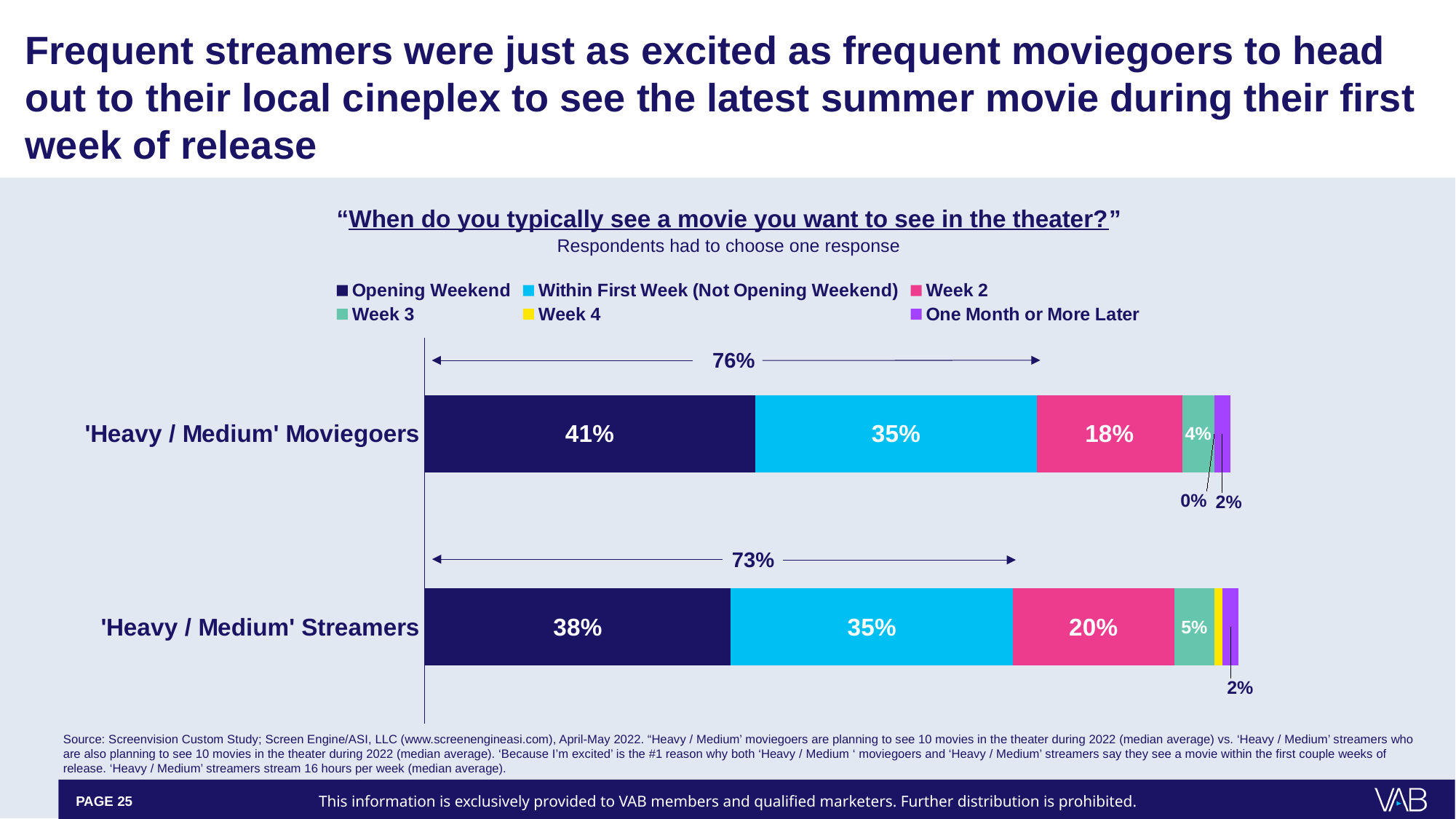
How many respondent groups (categories) are plotted in the chart? 2 What is the Week 4 value for 'Heavy / Medium' Moviegoers? 0% Which group has the larger Opening Weekend share, 'Heavy / Medium' Moviegoers or 'Heavy / Medium' Streamers? 'Heavy / Medium' Moviegoers How many series does the legend list? 6 Which legend entry is shown in yellow? Week 4 What is the Week 3 value for 'Heavy / Medium' Moviegoers? 4% What is the Opening Weekend value for 'Heavy / Medium' Streamers? 38% What combined share of 'Heavy / Medium' Moviegoers see a movie within the first week (Opening Weekend plus Within First Week), as annotated on the chart? 76% What is the Week 2 value for 'Heavy / Medium' Streamers? 20% What is the difference between the Week 2 values for 'Heavy / Medium' Streamers and 'Heavy / Medium' Moviegoers? 2% What is the Opening Weekend value for 'Heavy / Medium' Moviegoers? 41% What kind of chart is shown on the slide? Stacked bar chart